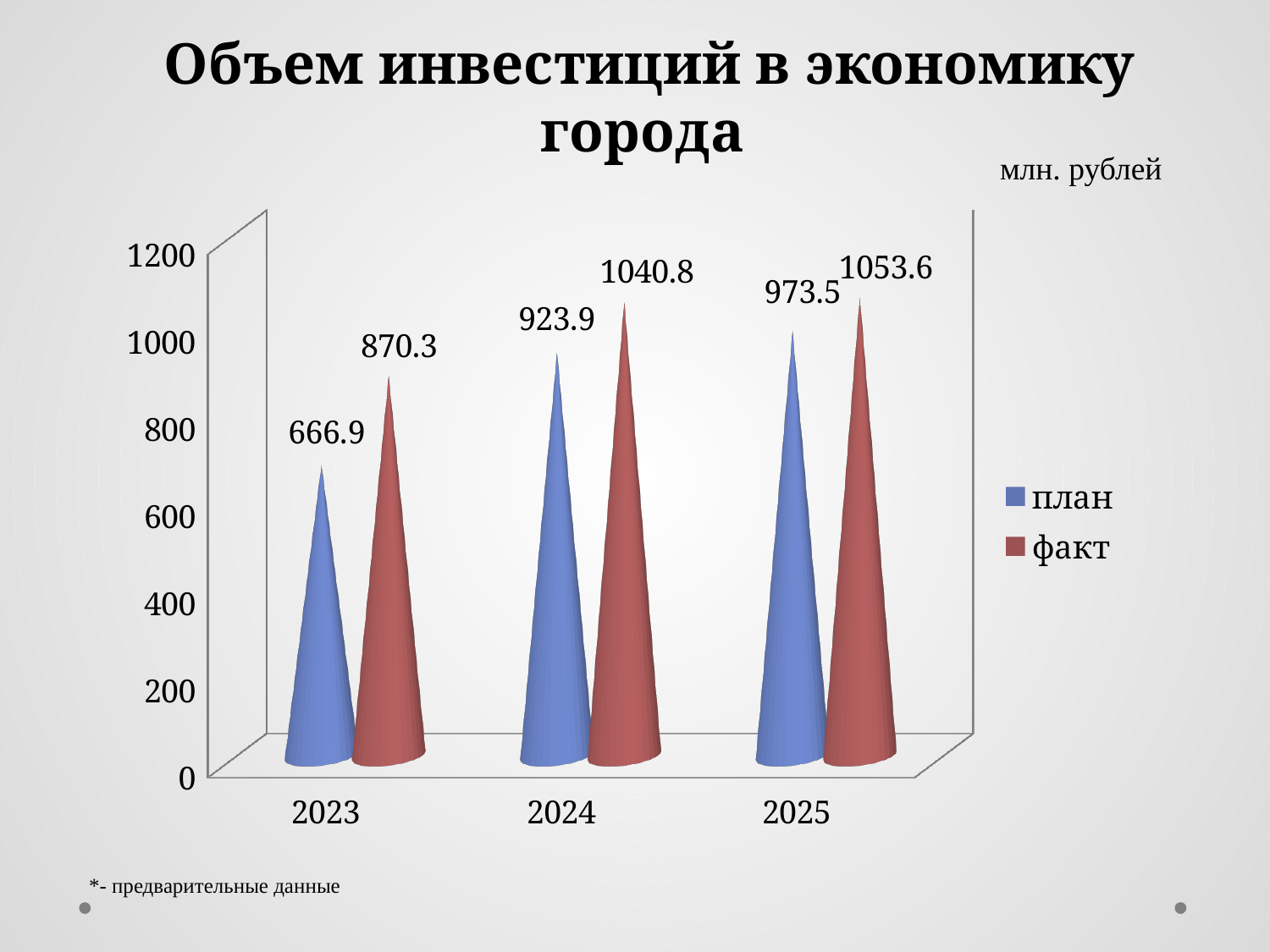
What is the difference between факт and план in 2023? 203.4 How many series does the legend list? 2 What is the value for факт in 2024? 1040.8 Does the план value rise or fall from 2023 to 2025? rise In which year is the факт value highest? 2025 In which year is the план value lowest? 2023 What unit of measurement is stated on the slide for the chart values? млн. рублей Which is larger in 2024: план or факт? факт What is the difference between факт and план in 2025? 80.1 How many years are shown on the x axis? 3 What is the value for план in 2023? 666.9 What is the value for план in 2025? 973.5